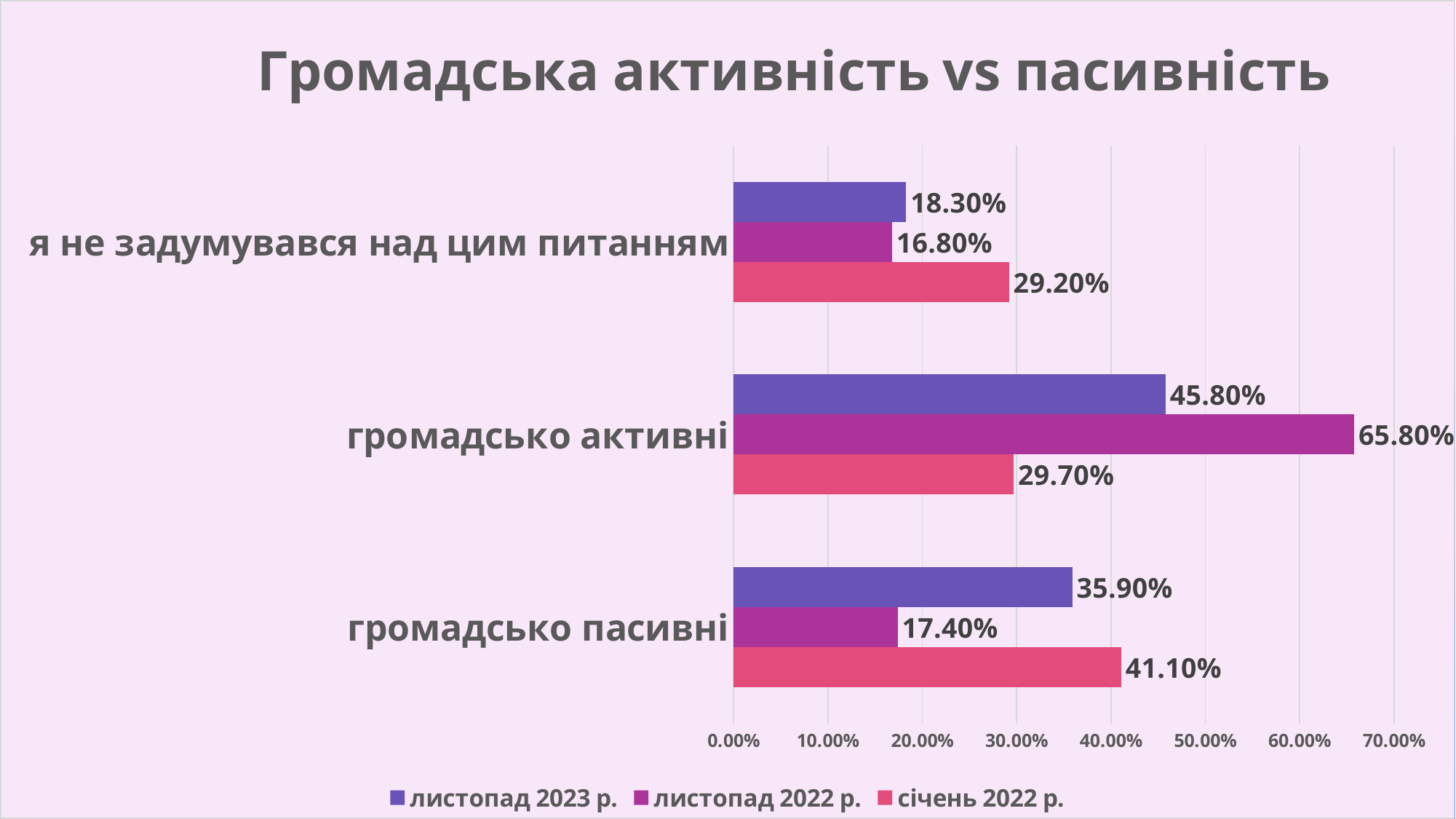
What is the value for "громадсько активні" in the "листопад 2022 р." series? 65.80% How many categories are shown on the chart? 3 What is the value for "я не задумувався над цим питанням" in the "листопад 2023 р." series? 18.30% How many series does the legend list? 3 What is the title of the chart? Громадська активність vs пасивність What kind of chart is shown on the slide? bar chart Which category has the highest value in the "листопад 2023 р." series? громадсько активні What is the difference between the "листопад 2022 р." and "листопад 2023 р." values for "громадсько активні"? 20.00% What is the value for "громадсько пасивні" in the "січень 2022 р." series? 41.10% Is the "листопад 2022 р." value for "громадсько активні" greater or less than 60.00%? greater Which category has the lowest value in the "листопад 2022 р." series? я не задумувався над цим питанням Which is larger for "громадсько пасивні": the "січень 2022 р." value or the "листопад 2023 р." value? січень 2022 р.